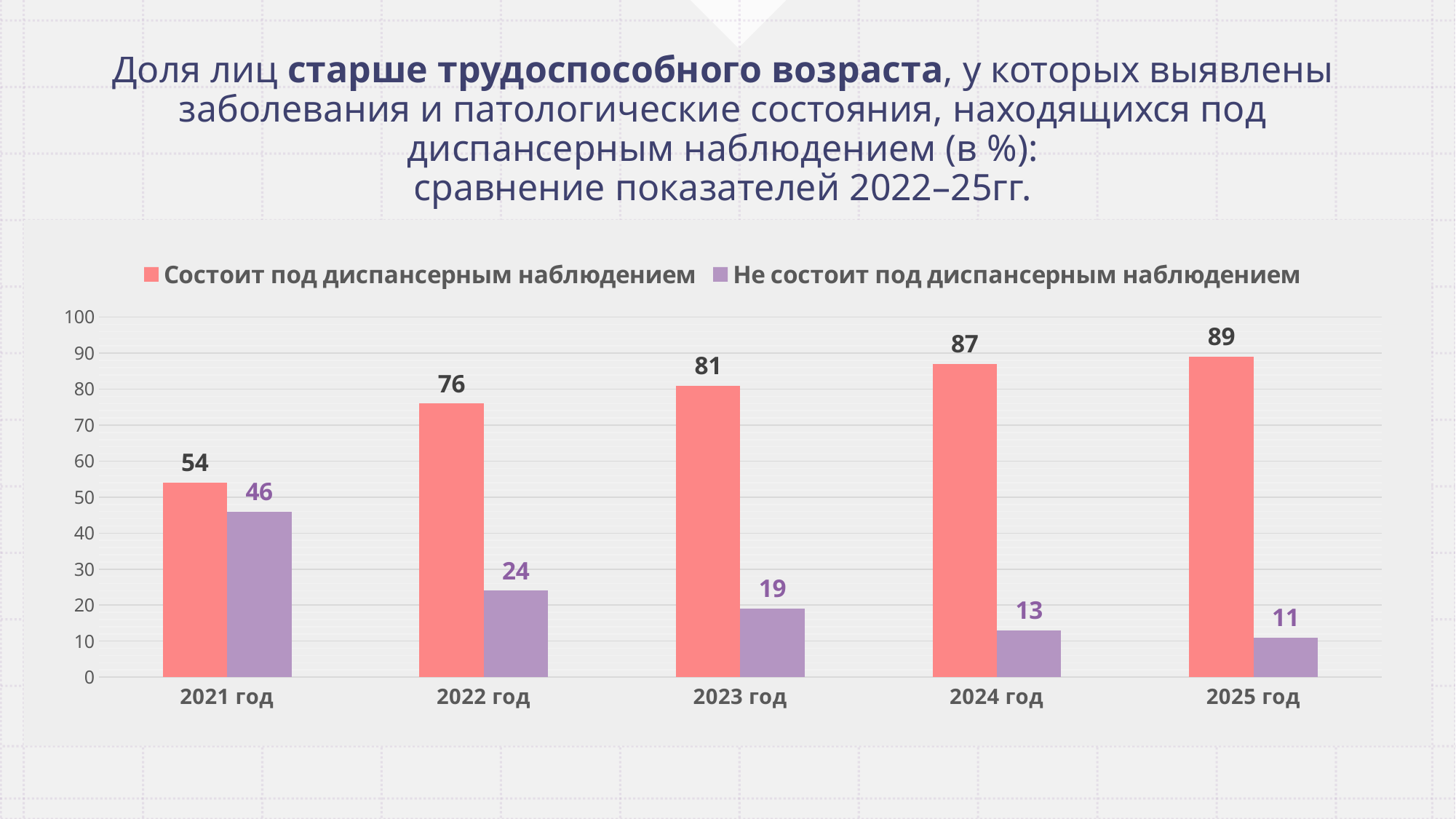
Which year has the highest value for "Состоит под диспансерным наблюдением"? 2025 год What kind of chart is shown on the slide? bar chart Does the value for "Не состоит под диспансерным наблюдением" rise or fall from 2021 год to 2025 год? fall How many years are shown on the x axis? 5 In 2022 год, which series has the larger value: "Состоит под диспансерным наблюдением" or "Не состоит под диспансерным наблюдением"? Состоит под диспансерным наблюдением Is the value for "Состоит под диспансерным наблюдением" in 2024 год greater or less than 80? greater What is the value for "Состоит под диспансерным наблюдением" in 2023 год? 81 How many series does the legend list? 2 What is the difference between the "Состоит под диспансерным наблюдением" values for 2025 год and 2021 год? 35 What is the value for "Не состоит под диспансерным наблюдением" in 2021 год? 46 Which year has the lowest value for "Не состоит под диспансерным наблюдением"? 2025 год What is the value for "Не состоит под диспансерным наблюдением" in 2025 год? 11